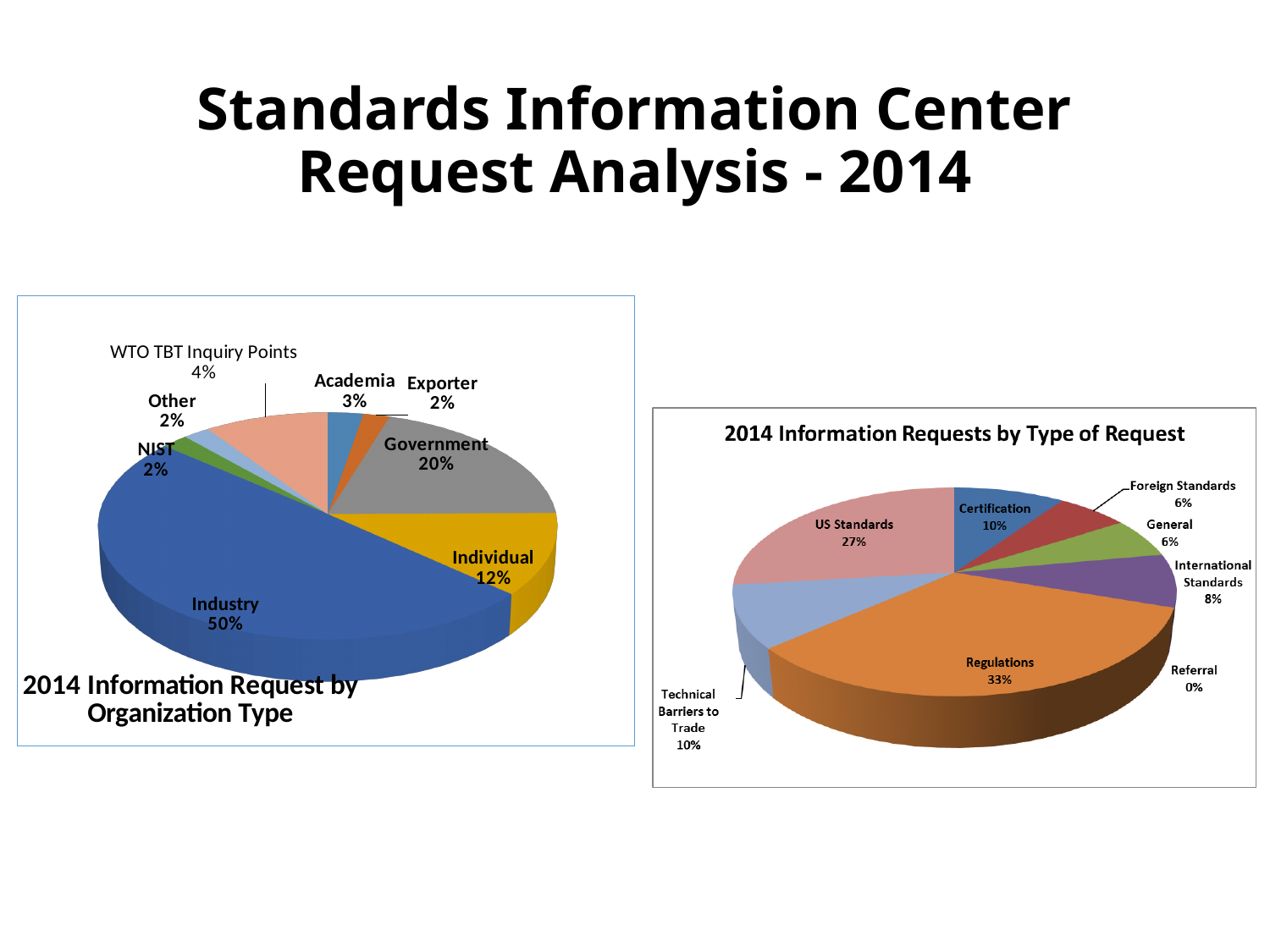
What kind of chart is the chart titled '2014 Information Requests by Type of Request'? Pie chart In the chart titled '2014 Information Request by Organization Type', what share of requests came from Government? 20% In the chart titled '2014 Information Request by Organization Type', which organization type has the largest share? Industry In the chart titled '2014 Information Request by Organization Type', how many organization types are shown? 8 In the chart titled '2014 Information Request by Organization Type', what is the difference in percentage points between Government and Individual? 8 In the chart titled '2014 Information Request by Organization Type', what share of requests came from WTO TBT Inquiry Points? 4% In the chart titled '2014 Information Requests by Type of Request', how many types of request are shown? 8 In the chart titled '2014 Information Requests by Type of Request', what share of requests were for Regulations? 33% In the chart titled '2014 Information Requests by Type of Request', which type of request has the smallest share? Referral In the chart titled '2014 Information Requests by Type of Request', what share of requests were for US Standards? 27% In the chart titled '2014 Information Request by Organization Type', what share of requests came from Industry? 50% In the chart titled '2014 Information Requests by Type of Request', which is larger: International Standards or Certification? Certification